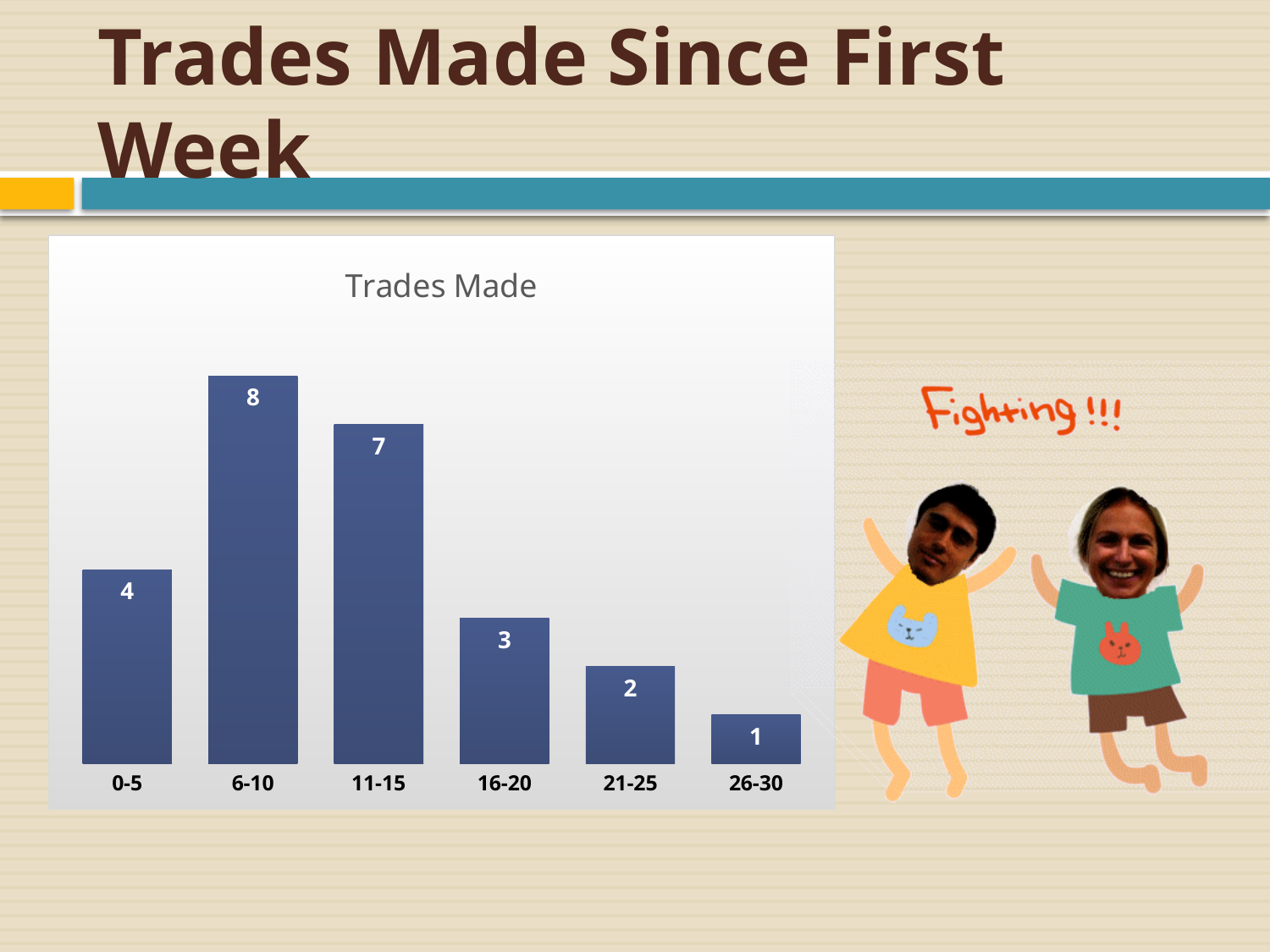
What is the difference between the values for 0-5 and 26-30? 3 How many categories are shown on the x axis? 6 Which category has the lowest value? 26-30 What kind of chart is shown? bar chart What is the value for the 0-5 category? 4 Do the values rise or fall from the 6-10 category to the 26-30 category? fall What is the value for the 6-10 category? 8 What is the value for the 16-20 category? 3 Which category has the highest value? 6-10 What is the difference between the values for 6-10 and 11-15? 1 Which is larger, the value for 0-5 or the value for 21-25? 0-5 What is the title of the chart? Trades Made